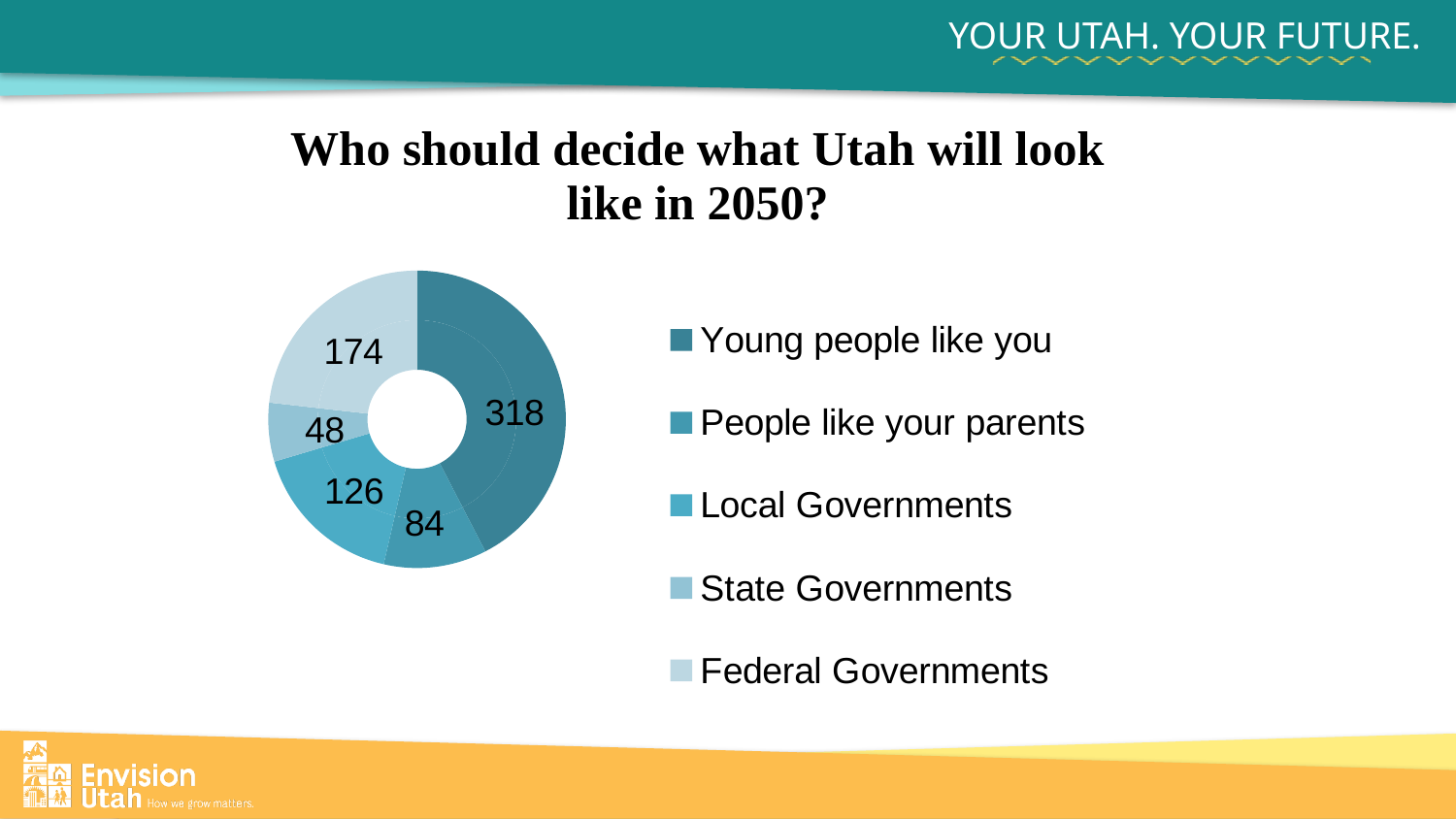
What is the value for Local Governments? 126 What is the value for State Governments? 48 What kind of chart is shown on the slide? doughnut chart What is the title of the chart? Who should decide what Utah will look like in 2050? What is the value for Young people like you? 318 What is the value for Federal Governments? 174 Which category has the lowest value? State Governments Which category has the highest value? Young people like you What is the difference between the values for Young people like you and Federal Governments? 144 Which is larger, the value for Local Governments or the value for People like your parents? Local Governments What is the total of all the values in the chart? 750 How many categories does the chart show? 5